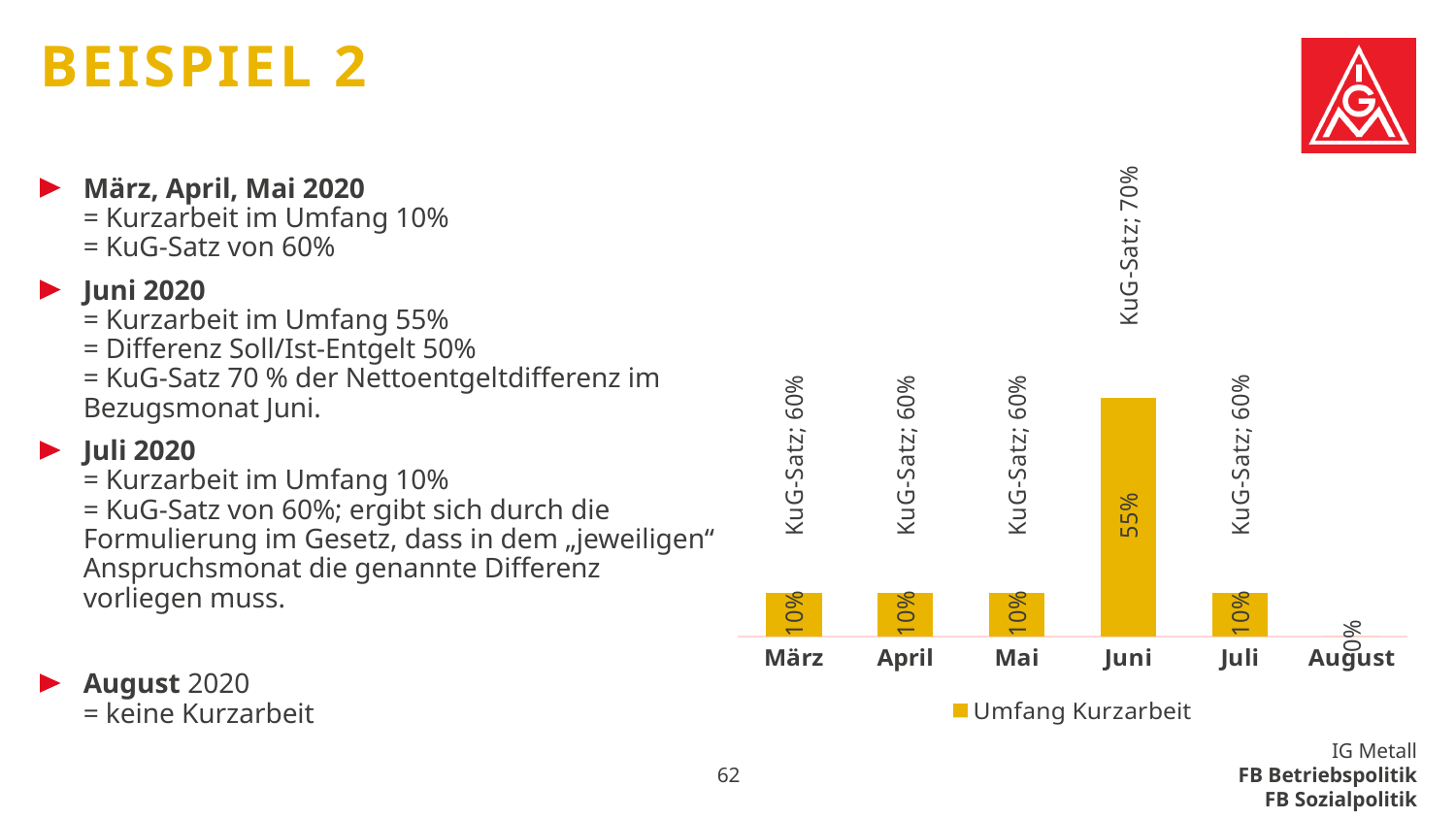
What is the legend entry of the chart? Umfang Kurzarbeit Which is larger, the Umfang Kurzarbeit for Juni or for Mai? Juni Which month has the lowest Umfang Kurzarbeit? August What is the value of Umfang Kurzarbeit for Juni? 55% How many series does the chart legend list? 1 Which month has the highest Umfang Kurzarbeit? Juni How many months are shown on the x axis of the chart? 6 What KuG-Satz is labelled above the Juni bar? KuG-Satz; 70% What kind of chart is shown on the slide? bar chart What is the value of Umfang Kurzarbeit for August? 0% What is the value of Umfang Kurzarbeit for März? 10% What is the difference between the Umfang Kurzarbeit for Juni and for Juli? 45%